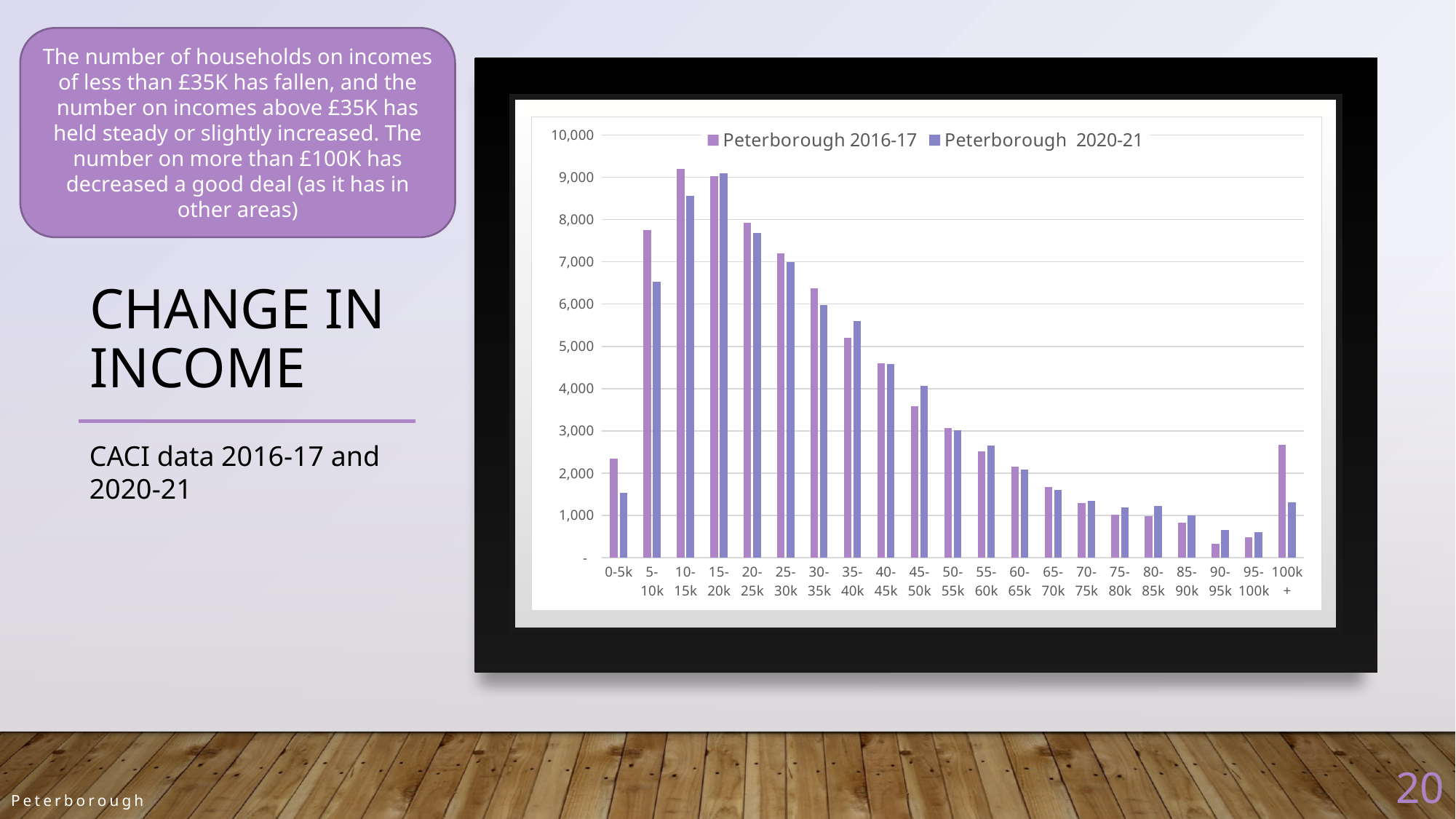
For the 100k+ band, which series has the larger value, Peterborough 2016-17 or Peterborough 2020-21? Peterborough 2016-17 Is the Peterborough 2016-17 value for 0-5k greater or less than 2,000? greater What kind of chart is shown on the slide? bar chart Which income band has the lowest value for Peterborough 2016-17? 90-95k For the 35-40k band, which series has the larger value, Peterborough 2016-17 or Peterborough 2020-21? Peterborough 2020-21 What are the two series names listed in the chart legend? Peterborough 2016-17 and Peterborough 2020-21 Which income band has the highest value for Peterborough 2020-21? 15-20k How many series does the chart legend list? 2 Is the Peterborough 2016-17 value for 100k+ greater or less than 2,000? greater From the 10-15k band to the 95-100k band, do the Peterborough 2016-17 values generally rise or fall? fall How many income bands are shown along the x axis of the chart? 21 Is the Peterborough 2020-21 value for 5-10k greater or less than 7,000? less